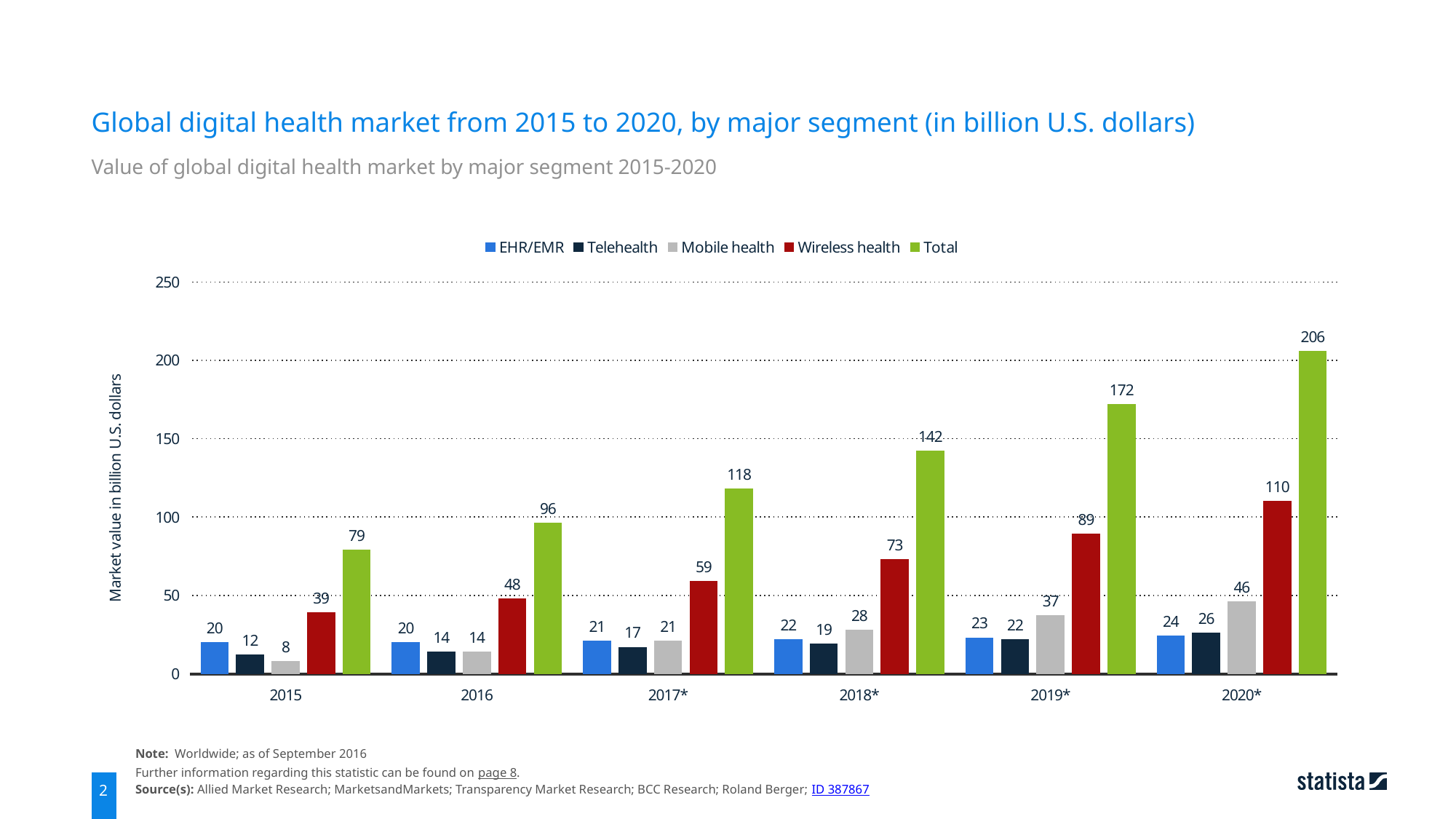
How many series does the legend list? 5 Which year has the highest Total value? 2020* Which is larger in 2017*: Wireless health or Mobile health? Wireless health What kind of chart is shown on the slide? Bar chart What is the Mobile health value for 2015? 8 Does the Wireless health value rise or fall from 2015 to 2020*? Rise How many years are shown on the x axis? 6 Which year has the lowest Mobile health value? 2015 What is the Telehealth value for 2019*? 22 What is the Wireless health value for 2018*? 73 What is the Total value for 2020*? 206 What is the difference between the Total values for 2020* and 2019*? 34